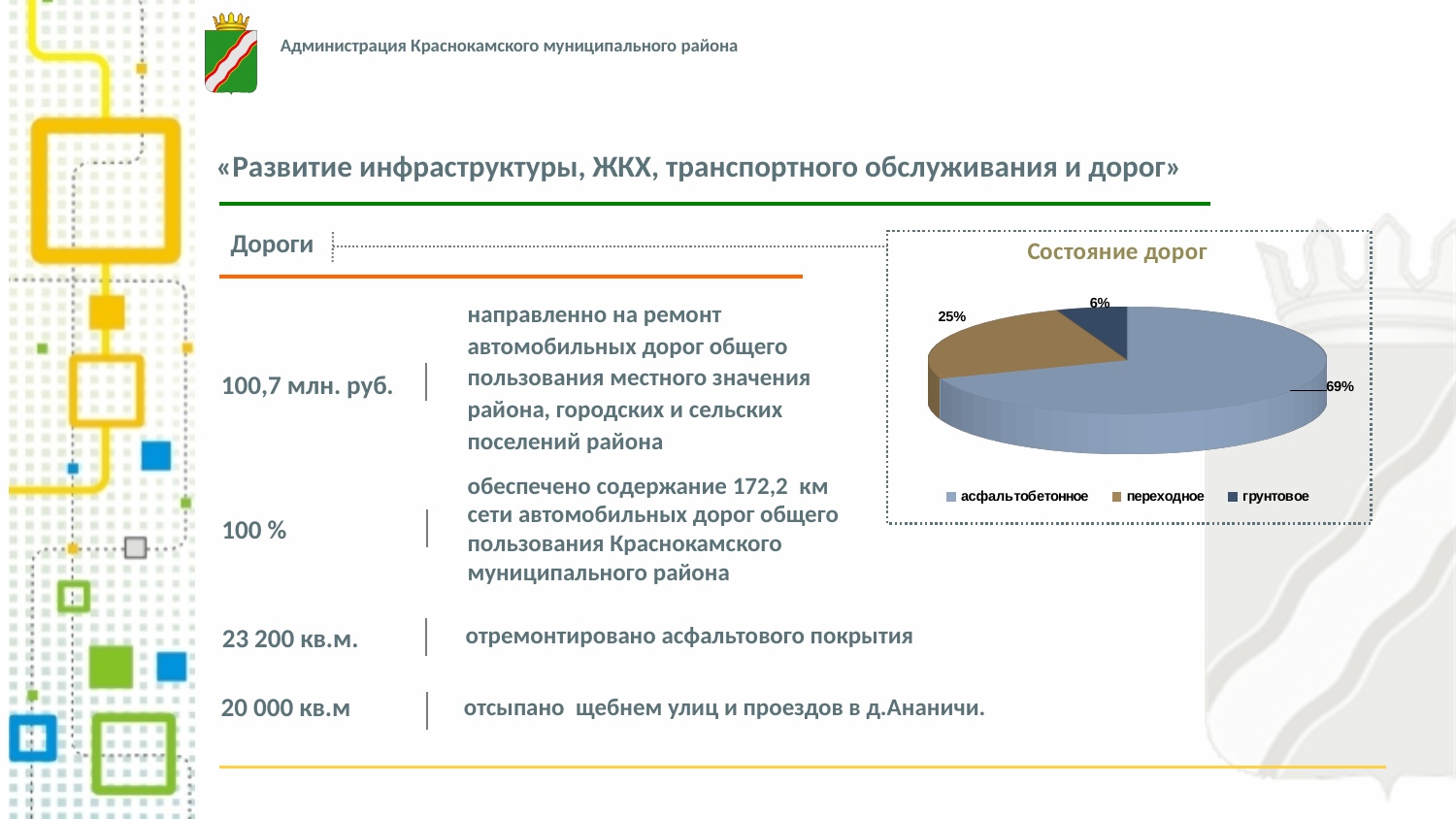
What share of the pie does переходное have? 25% Which category has the smallest slice of the pie? грунтовое What share of the pie does асфальтобетонное have? 69% Which is larger, the share for переходное or the share for грунтовое? переходное What kind of chart is shown on the slide? pie chart Which category has the largest slice of the pie? асфальтобетонное What is the difference in percentage points between асфальтобетонное and переходное? 44 How many slices does the pie chart have? 3 What is the difference in percentage points between переходное and грунтовое? 19 How many entries does the legend list? 3 What share of the pie does грунтовое have? 6% What is the title of the chart? Состояние дорог